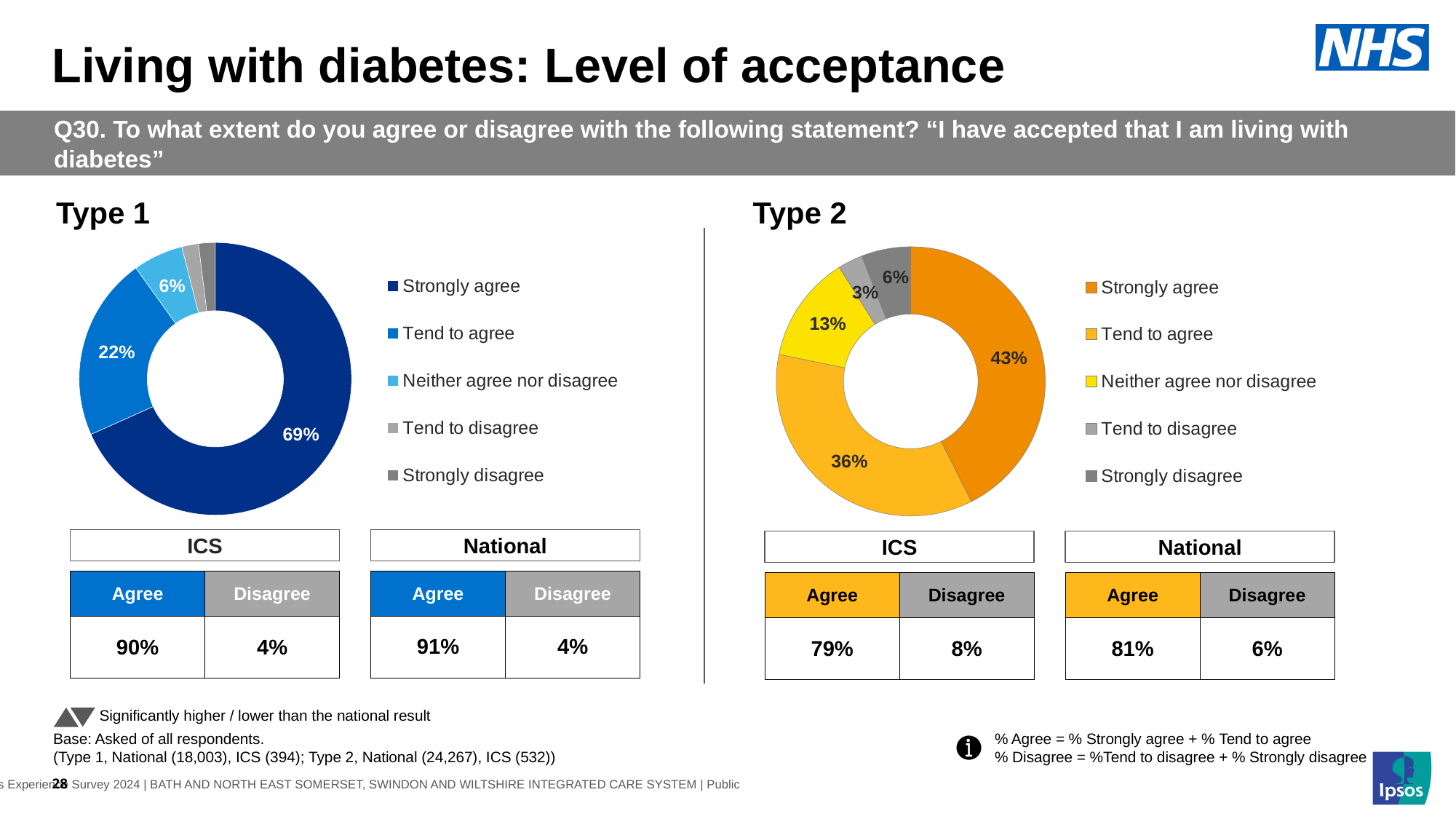
In the Type 2 chart, which category has the largest share? Strongly agree In the Type 2 chart, what percentage of respondents neither agree nor disagree? 13% In the Type 2 chart, what percentage of respondents strongly disagree? 6% In the Type 1 chart, what is the difference between the Strongly agree and Tend to agree shares? 47 percentage points What kind of chart is used for Type 1? Doughnut (pie) chart In the Type 1 chart, what percentage of respondents tend to agree? 22% What colour represents Strongly agree in the Type 2 chart? Orange In the Type 1 chart, what percentage of respondents strongly agree? 69% In the Type 2 chart, which category has the smallest share? Tend to disagree How many categories does the legend of the Type 1 chart list? 5 In the Type 2 chart, what is the difference between the Strongly agree and Tend to agree shares? 7 percentage points Which chart has the larger Strongly agree share, Type 1 or Type 2? Type 1